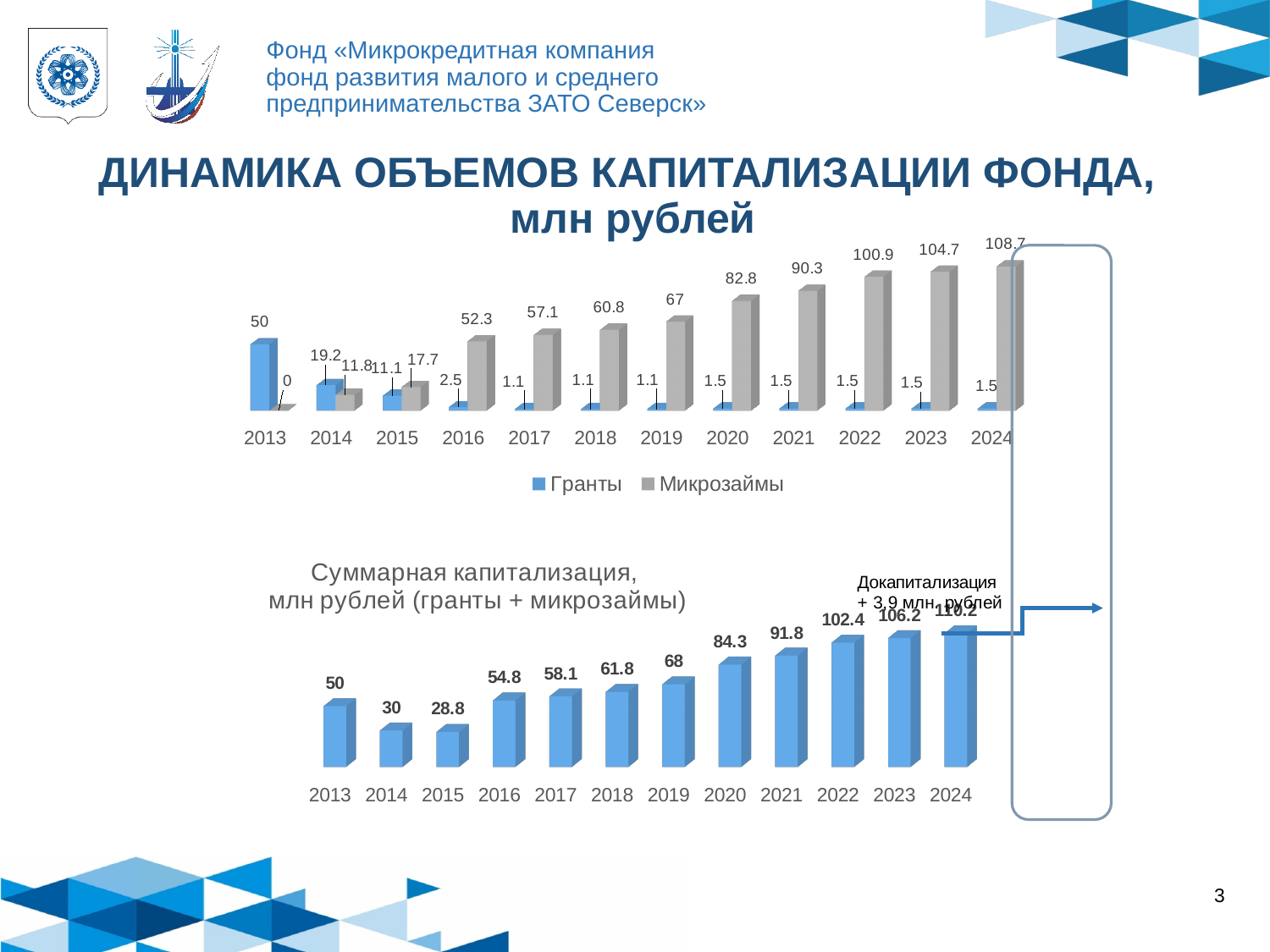
In the bottom chart (Суммарная капитализация), how many years are shown on the x axis? 12 In the bottom chart (Суммарная капитализация), is the value for 2021 or 2022 larger? 2022 In the top chart, which series is shown in gray? Микрозаймы In the bottom chart (Суммарная капитализация), which year has the lowest value? 2015 In the top chart, which year has the lowest Микрозаймы value? 2013 In the top chart, what is the difference between the Микрозаймы values for 2022 and 2021? 10.6 In the top chart, what is the value of Микрозаймы for 2024? 108.7 In the top chart, what is the value of Микрозаймы for 2020? 82.8 In the top chart, how many series does the legend list? 2 In the bottom chart (Суммарная капитализация), what is the value for 2019? 68 In the top chart, which year has the highest Гранты value? 2013 In the top chart, what is the value of Гранты for 2013? 50